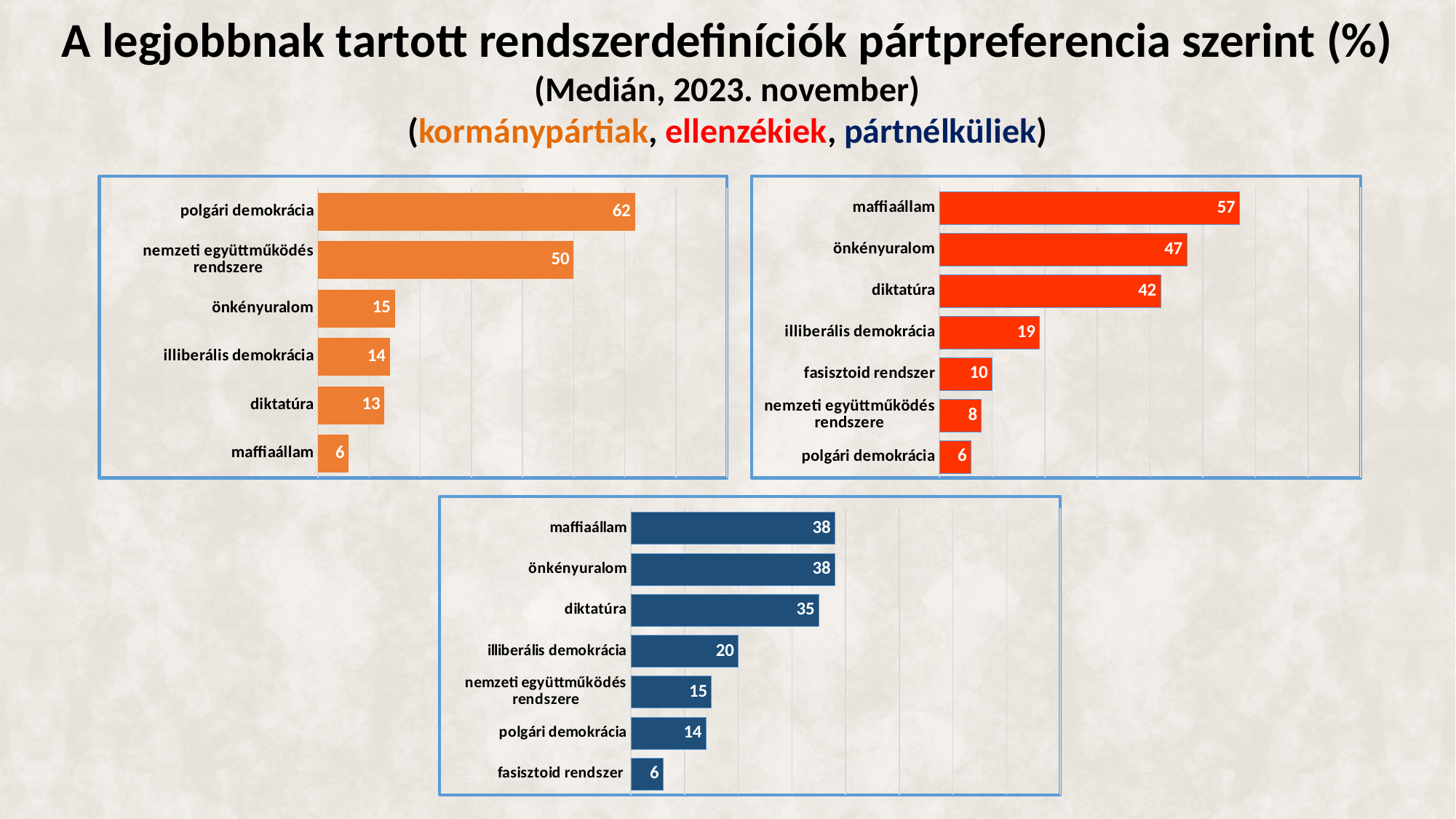
In the bottom (blue) chart, what is the value for illiberális demokrácia? 20 How many categories are shown in the top-right (red) chart? 7 In the bottom (blue) chart, what is the difference between diktatúra and polgári demokrácia? 21 In the top-left (orange) chart, which category has the lowest value? maffiaállam In the top-left (orange) chart, what is the value for polgári demokrácia? 62 What kind of chart is the bottom (blue) chart? bar chart In the top-right (red) chart, which is larger: illiberális demokrácia or fasisztoid rendszer? illiberális demokrácia In the top-right (red) chart, what is the value for diktatúra? 42 In the bottom (blue) chart, which category has the lowest value? fasisztoid rendszer How many categories are shown in the top-left (orange) chart? 6 In the top-left (orange) chart, what is the difference between polgári demokrácia and nemzeti együttműködés rendszere? 12 In the top-right (red) chart, which category has the highest value? maffiaállam